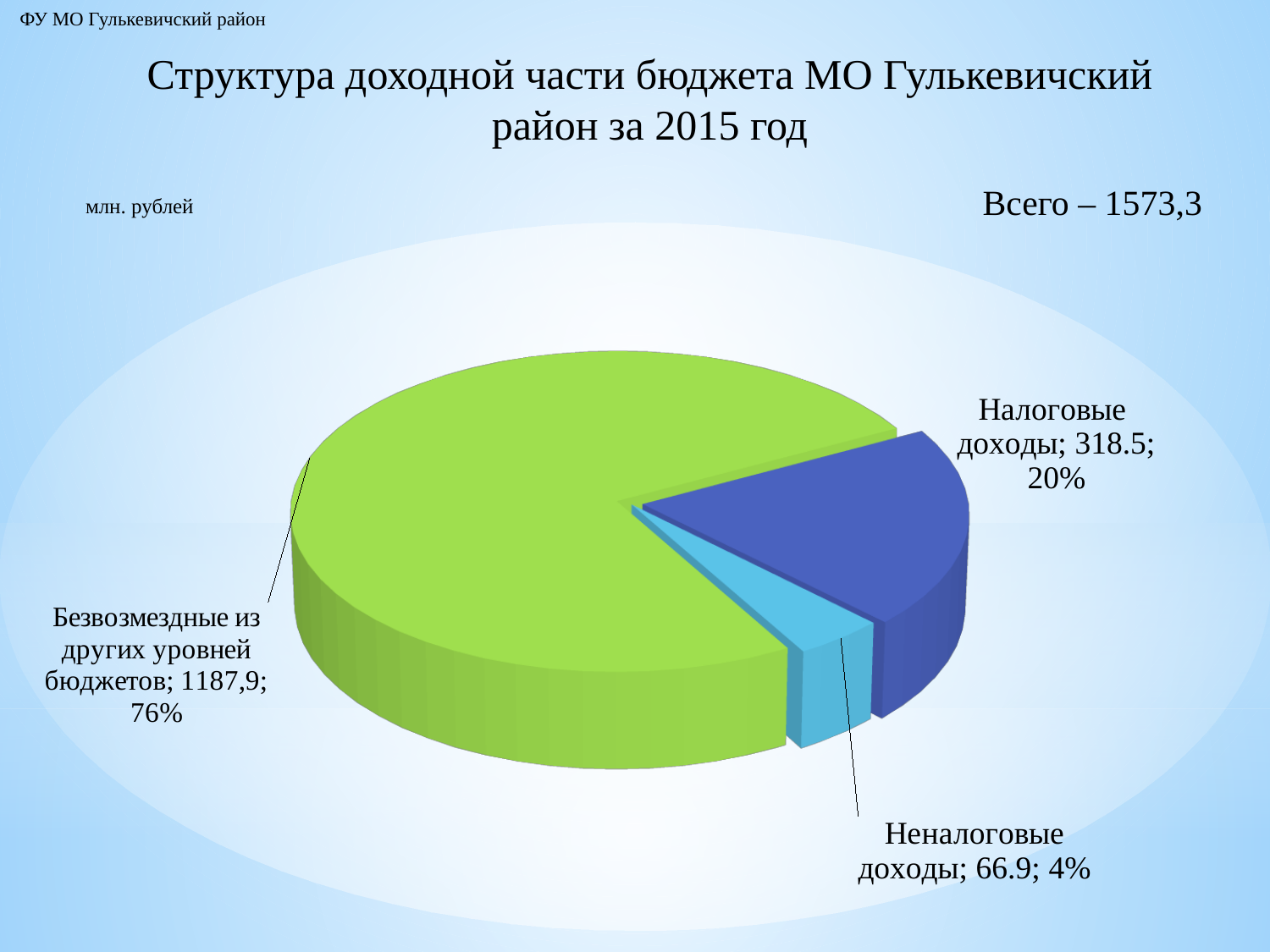
What is the value for Налоговые доходы? 318.5 How many slices does the pie chart have? 3 What is the difference between Налоговые доходы and Неналоговые доходы? 251.6 What share of the pie does Налоговые доходы represent? 20% What type of chart is shown on the slide? pie chart What is the value for Безвозмездные из других уровней бюджетов? 1187,9 What is the value for Неналоговые доходы? 66.9 Which is larger, Налоговые доходы or Неналоговые доходы? Налоговые доходы Which category has the smallest slice? Неналоговые доходы What share of the pie does Неналоговые доходы represent? 4% What share of the pie does Безвозмездные из других уровней бюджетов represent? 76% Which category has the largest slice? Безвозмездные из других уровней бюджетов